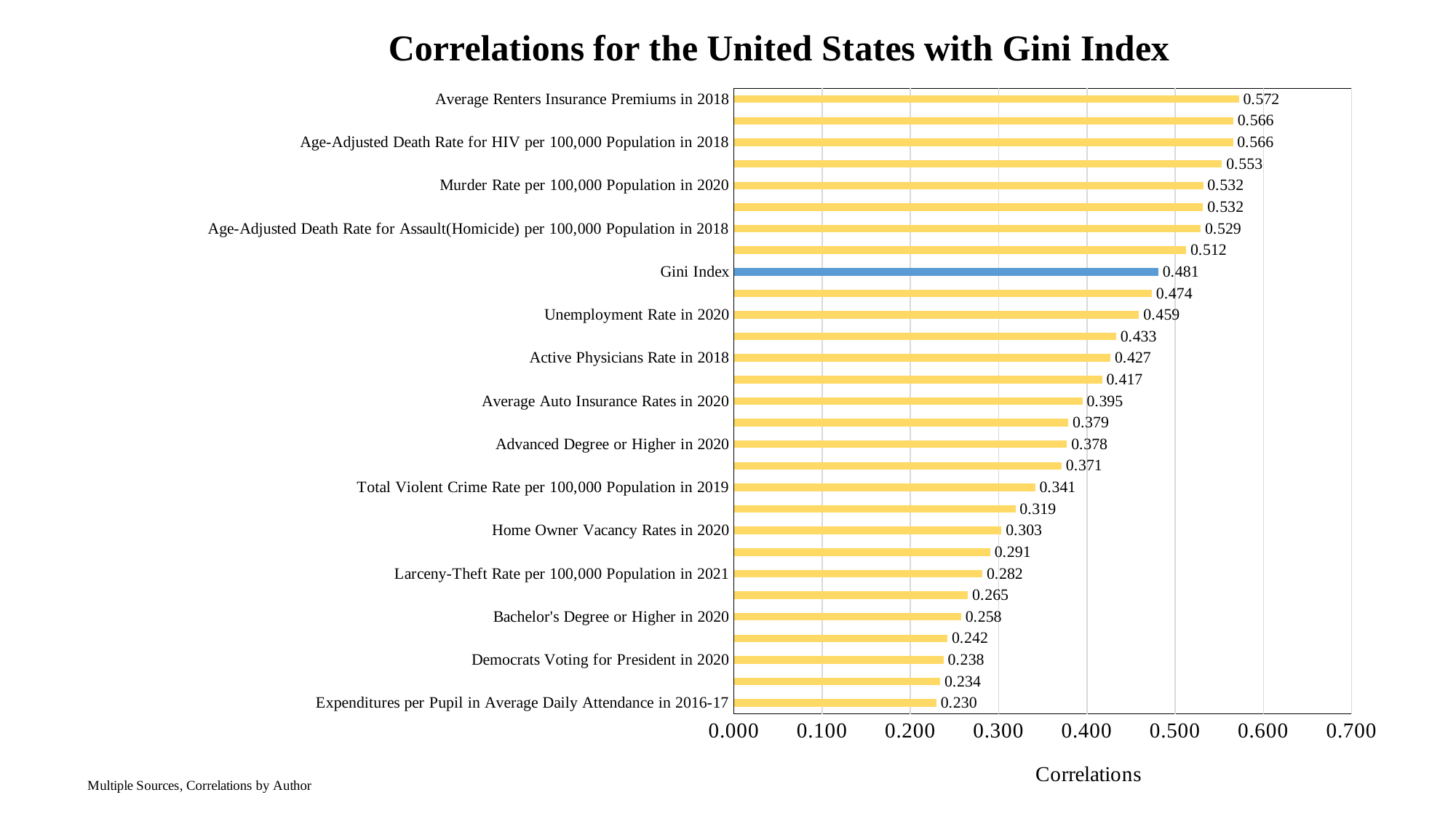
What is the difference between the correlation values for Murder Rate per 100,000 Population in 2020 and Home Owner Vacancy Rates in 2020? 0.229 Which labeled category has the highest correlation value? Average Renters Insurance Premiums in 2018 What is the correlation value for the Gini Index bar? 0.481 Which has a larger correlation value: Active Physicians Rate in 2018 or Advanced Degree or Higher in 2020? Active Physicians Rate in 2018 What is the title of the chart? Correlations for the United States with Gini Index How many bars are plotted in the chart? 29 What is the correlation value for Unemployment Rate in 2020? 0.459 What is the correlation value for Expenditures per Pupil in Average Daily Attendance in 2016-17? 0.230 Which labeled category has the lowest correlation value? Expenditures per Pupil in Average Daily Attendance in 2016-17 What is the correlation value for Average Renters Insurance Premiums in 2018? 0.572 What kind of chart is shown on the slide? Bar chart Is the value for Total Violent Crime Rate per 100,000 Population in 2019 greater or less than 0.400? less